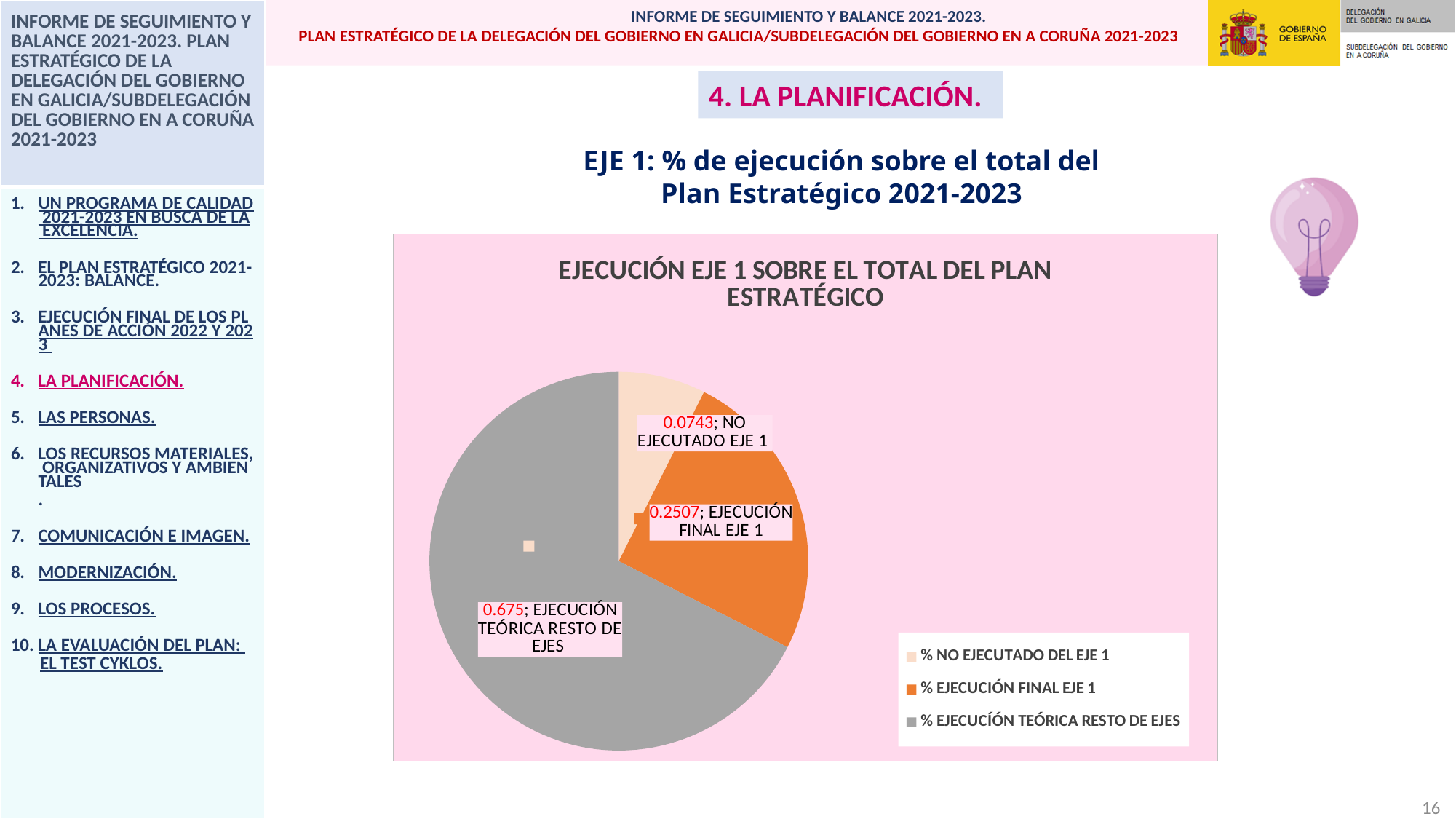
Which slice of the pie chart is the largest? EJECUCIÓN TEÓRICA RESTO DE EJES How many slices does the pie chart have? 3 What is the title of the chart? EJECUCIÓN EJE 1 SOBRE EL TOTAL DEL PLAN ESTRATÉGICO How many entries does the chart legend list? 3 Which is larger: the EJECUCIÓN FINAL EJE 1 slice or the NO EJECUTADO EJE 1 slice? EJECUCIÓN FINAL EJE 1 Which slice of the pie chart is the smallest? NO EJECUTADO EJE 1 What type of chart is shown on the slide? Pie chart What is the value shown for the EJECUCIÓN TEÓRICA RESTO DE EJES slice? 0.675 What is the difference between the EJECUCIÓN FINAL EJE 1 value and the NO EJECUTADO EJE 1 value? 0.1764 What is the value shown for the EJECUCIÓN FINAL EJE 1 slice? 0.2507 What is the value shown for the NO EJECUTADO EJE 1 slice? 0.0743 What is the difference between the EJECUCIÓN TEÓRICA RESTO DE EJES value and the EJECUCIÓN FINAL EJE 1 value? 0.4243